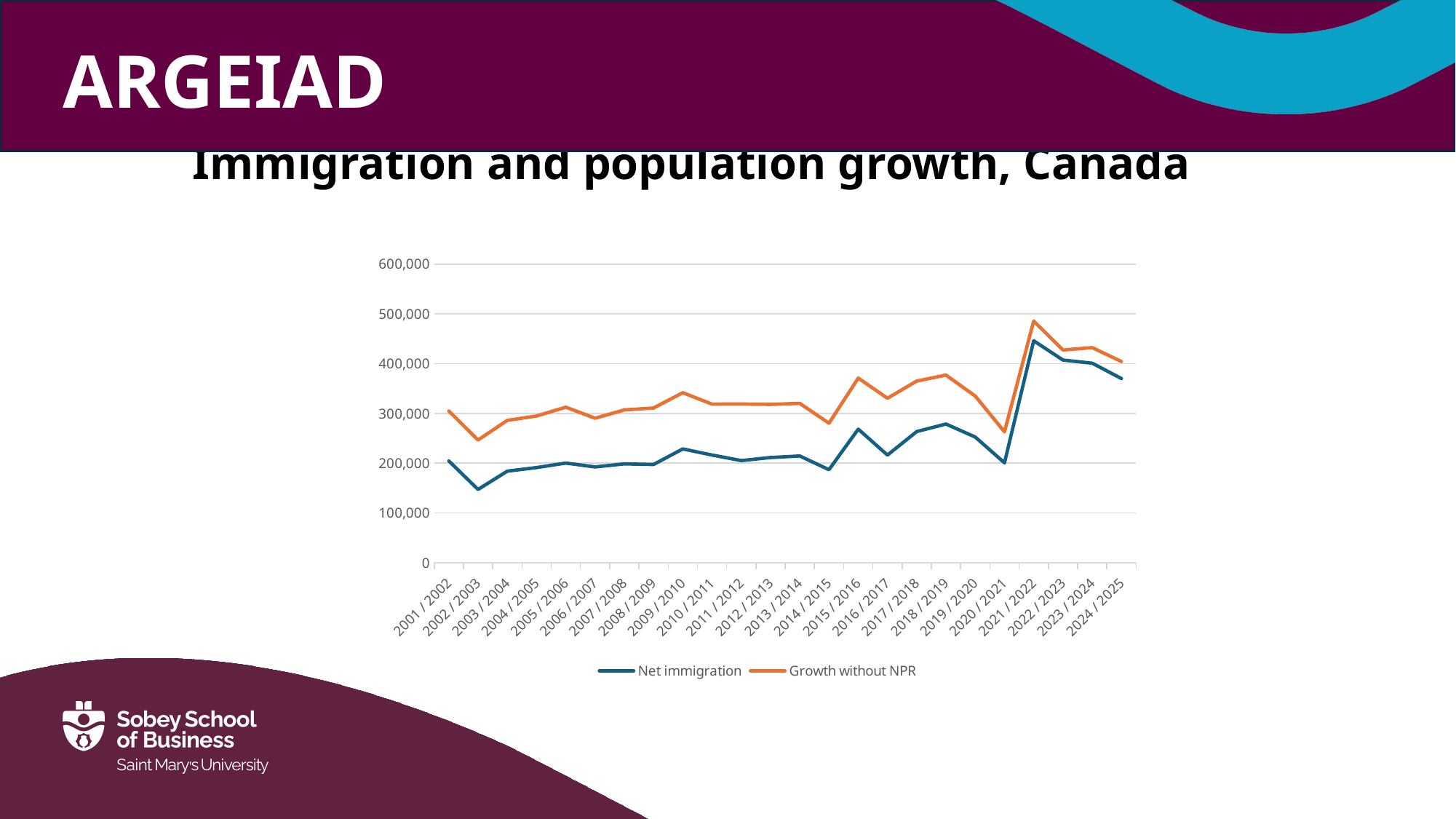
How many periods are plotted along the x axis? 24 In which period is Growth without NPR highest? 2021 / 2022 How many series does the legend list? 2 What is the title of the chart? Immigration and population growth, Canada In which period is Net immigration lowest? 2002 / 2003 Is the value for Net immigration in 2002 / 2003 greater or less than 200,000? less In which period is Net immigration highest? 2021 / 2022 Is the value for Growth without NPR in 2002 / 2003 greater or less than 300,000? less What kind of chart is shown on the slide? Line chart Does Net immigration rise or fall from 2021 / 2022 to 2024 / 2025? Fall In 2021 / 2022, which series has the larger value, Net immigration or Growth without NPR? Growth without NPR Is the value for Net immigration in 2021 / 2022 greater or less than 400,000? greater